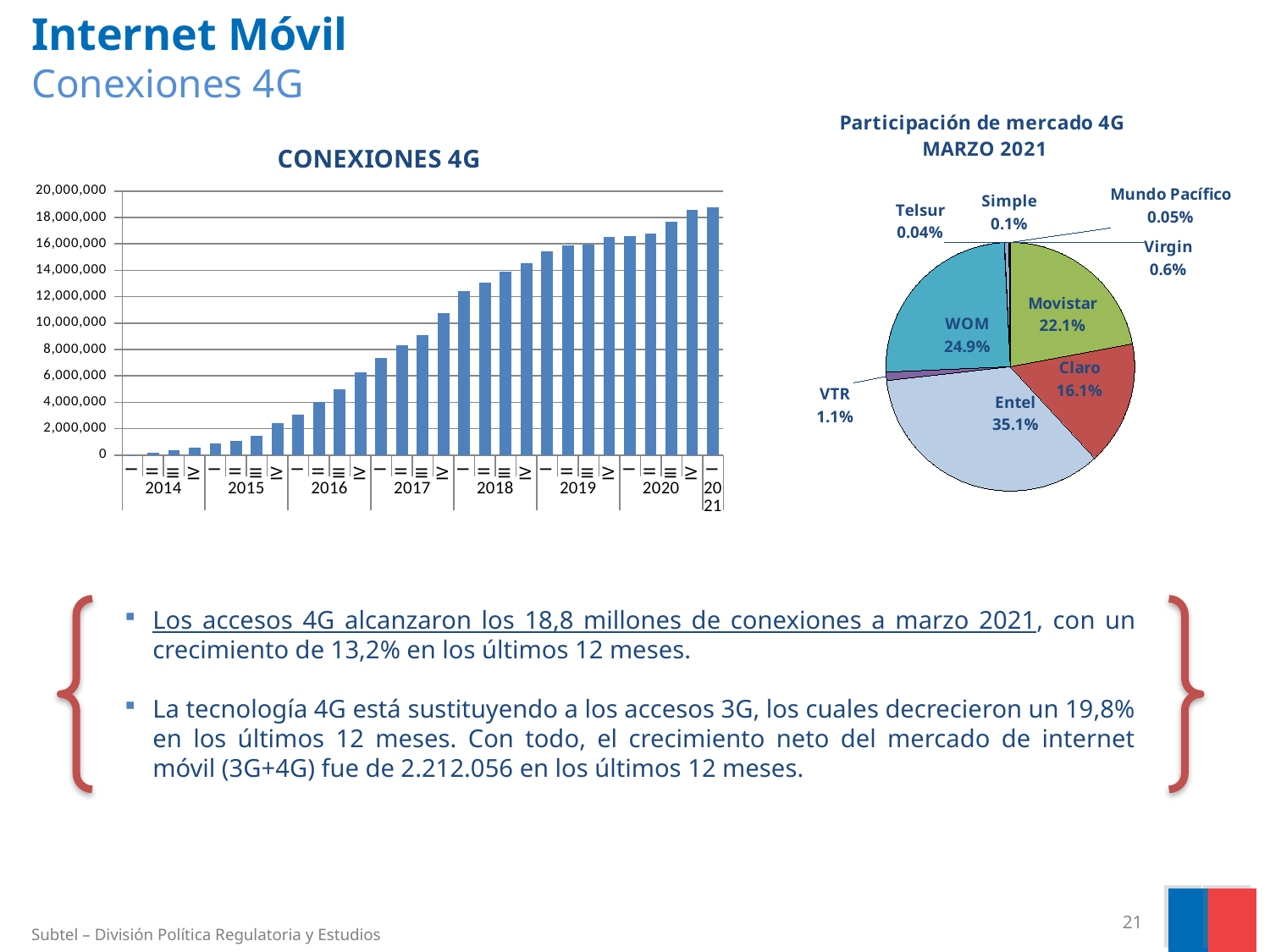
In the 'Participación de mercado 4G MARZO 2021' pie chart, which operator has the smallest share? Telsur In the 'Participación de mercado 4G MARZO 2021' pie chart, what is the difference between Entel's and Movistar's shares? 13.0% In the 'CONEXIONES 4G' chart, is the value for the first quarter of 2021 greater or less than 18,000,000? greater In the 'CONEXIONES 4G' chart, is the value for the first quarter of 2017 greater or less than 6,000,000? greater In the 'Participación de mercado 4G MARZO 2021' pie chart, what is Entel's share? 35.1% In the 'Participación de mercado 4G MARZO 2021' pie chart, which has a larger share, WOM or Movistar? WOM What kind of chart is 'CONEXIONES 4G'? Bar chart In the 'Participación de mercado 4G MARZO 2021' pie chart, what is WOM's share? 24.9% How many operators are shown in the 'Participación de mercado 4G MARZO 2021' pie chart? 9 In the 'Participación de mercado 4G MARZO 2021' pie chart, which operator has the largest share? Entel In the 'CONEXIONES 4G' chart, do the values rise or fall from 2014 to 2021? Rise In the 'Participación de mercado 4G MARZO 2021' pie chart, what is Claro's share? 16.1%